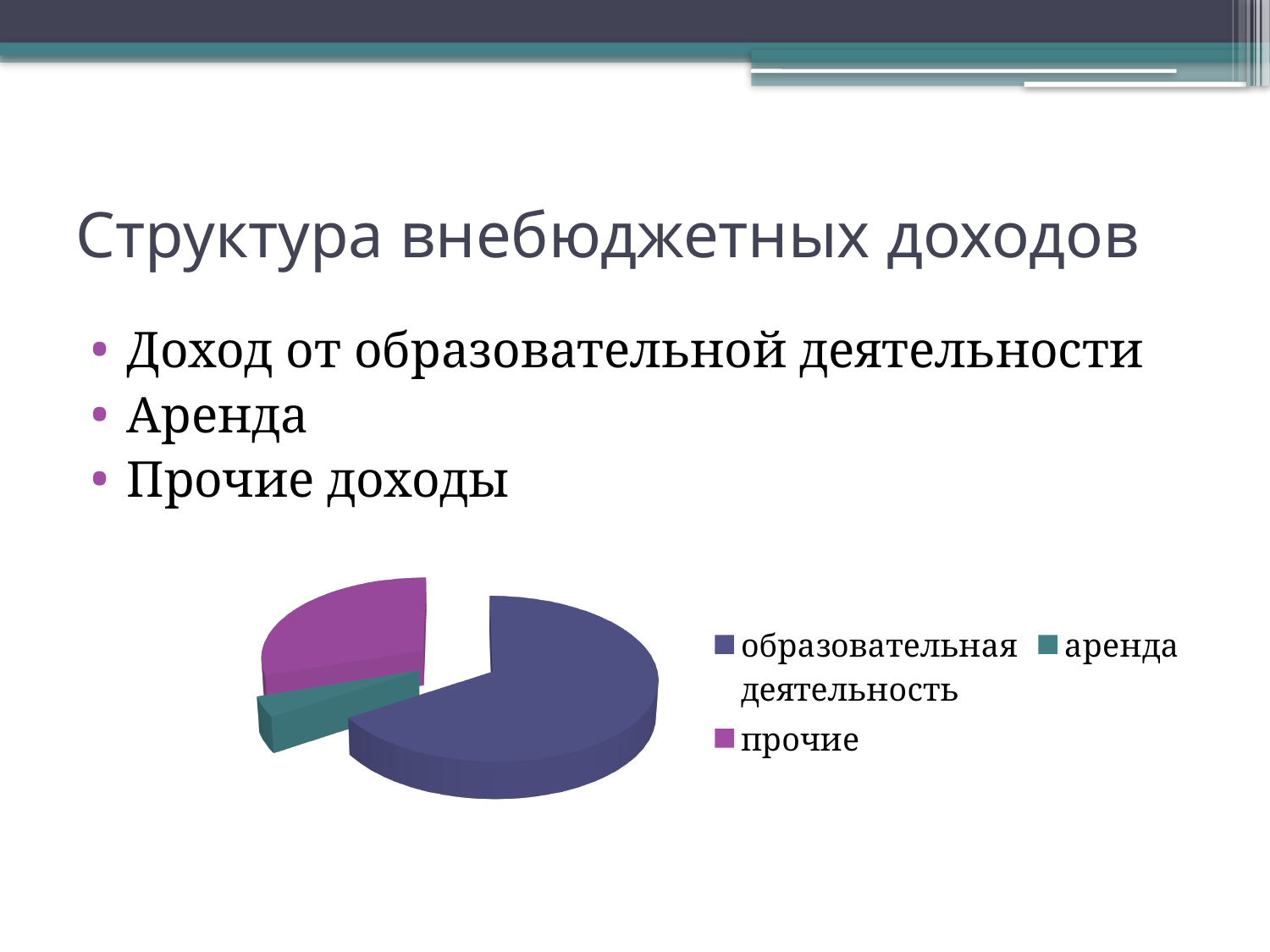
Which category has the smallest slice in the pie chart? аренда Which slice is larger in the pie chart, прочие or аренда? прочие Which category has the largest slice in the pie chart? образовательная деятельность Which slice is larger in the pie chart, образовательная деятельность or прочие? образовательная деятельность How many slices does the pie chart have? 3 Does the slice for образовательная деятельность take up more or less than half of the pie chart? more What kind of chart is shown on the slide? pie chart What are the three legend entries of the pie chart? образовательная деятельность, аренда, прочие What colour is the slice for аренда in the pie chart? teal How many entries does the legend of the pie chart list? 3